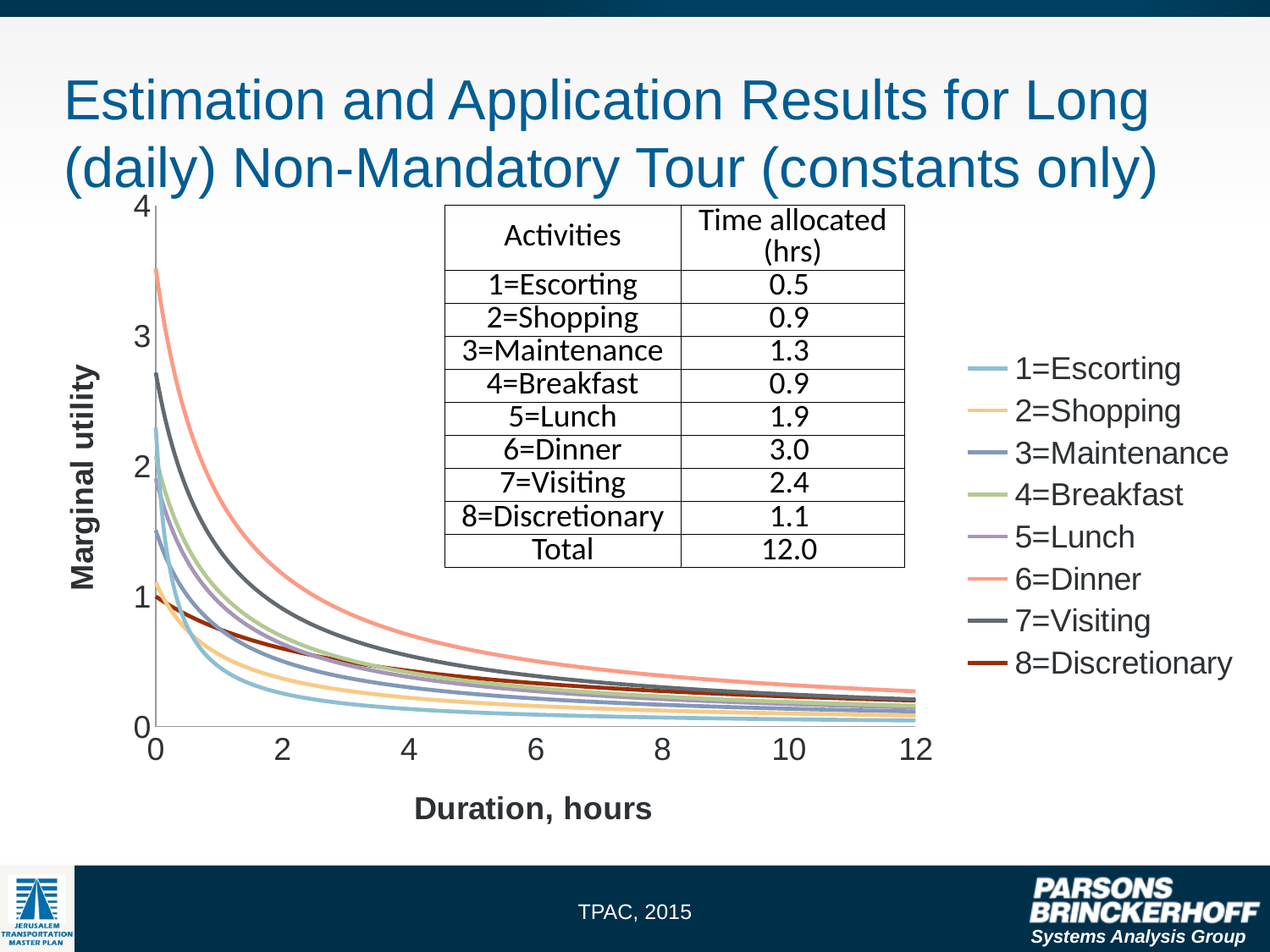
Is the marginal utility for 7=Visiting at a duration of 0 hours greater or less than 2? greater Is the marginal utility for 6=Dinner at a duration of 12 hours greater or less than 1? less What kind of chart is shown on the slide? line chart How many series does the chart legend list? 8 Is the marginal utility for 6=Dinner at a duration of 0 hours greater or less than 3? greater Which series has the highest marginal utility at a duration of 0 hours? 6=Dinner At a duration of 6 hours, which series has the larger marginal utility, 6=Dinner or 1=Escorting? 6=Dinner What is the title of the y axis of the chart? Marginal utility Do the marginal utility curves rise or fall as duration increases along the x axis? fall What is the title of the x axis of the chart? Duration, hours At a duration of 2 hours, which series has the larger marginal utility, 7=Visiting or 2=Shopping? 7=Visiting Which series has the lowest marginal utility at a duration of 12 hours? 1=Escorting